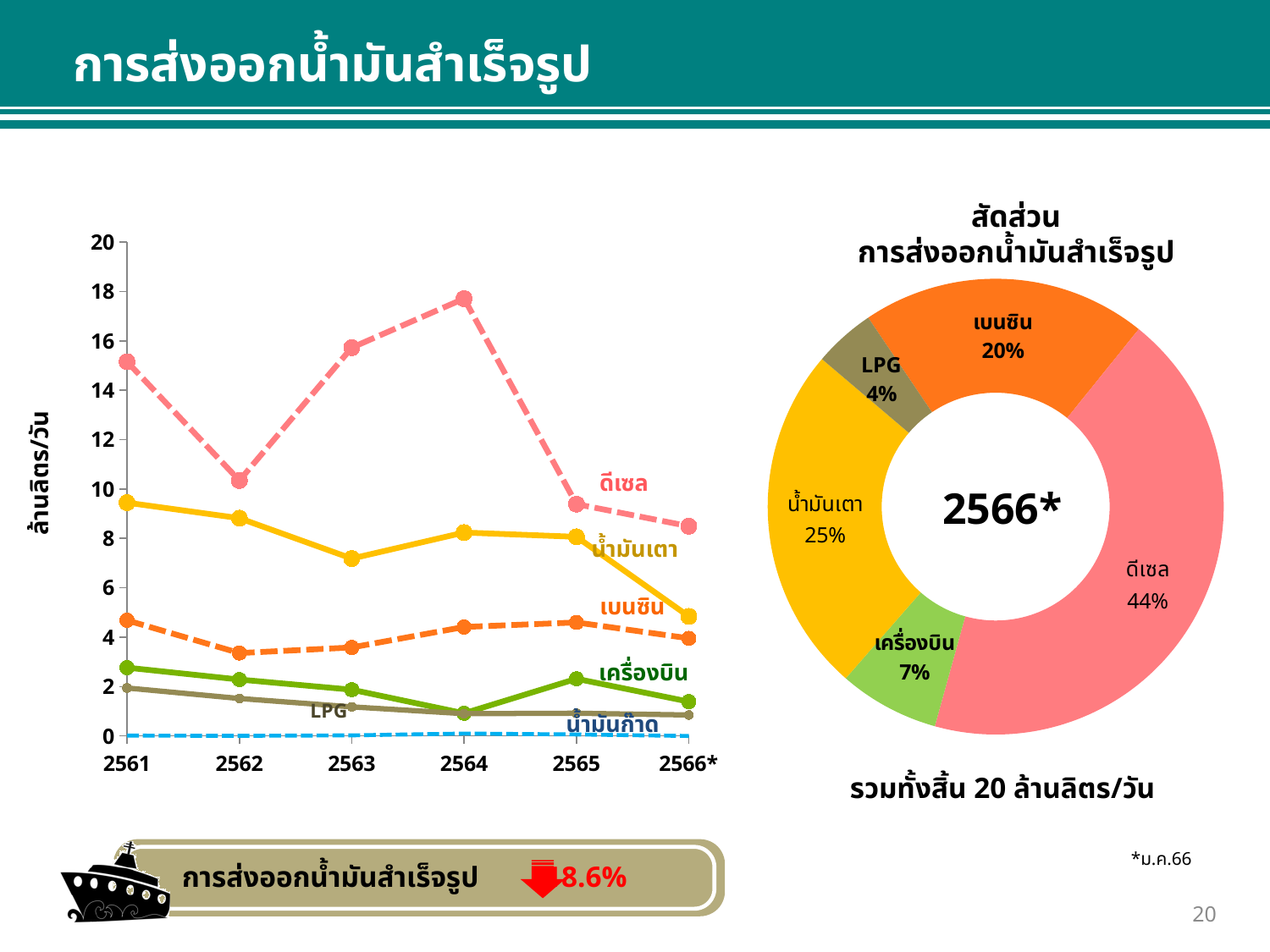
In the donut chart titled สัดส่วนการส่งออกน้ำมันสำเร็จรูป, what share does ดีเซล have? 44% In the line chart on the left, which is larger in 2565: เบนซิน or เครื่องบิน? เบนซิน In the donut chart on the right, which category has the largest share? ดีเซล In the donut chart on the right, which category has the smallest share? LPG In the donut chart on the right, what is the share for LPG? 4% In the donut chart on the right, how many categories are shown? 5 What kind of chart is shown on the left side of the slide? line chart In the donut chart on the right, what is the difference between the shares of เบนซิน and เครื่องบิน? 13% In the line chart on the left, is the value for น้ำมันเตา in 2566* greater or less than 6? less In the line chart on the left, which series has the highest value in 2561? ดีเซล In the line chart on the left, is the value for ดีเซล in 2564 greater or less than 16? greater In the donut chart on the right, what is the share for น้ำมันเตา? 25%